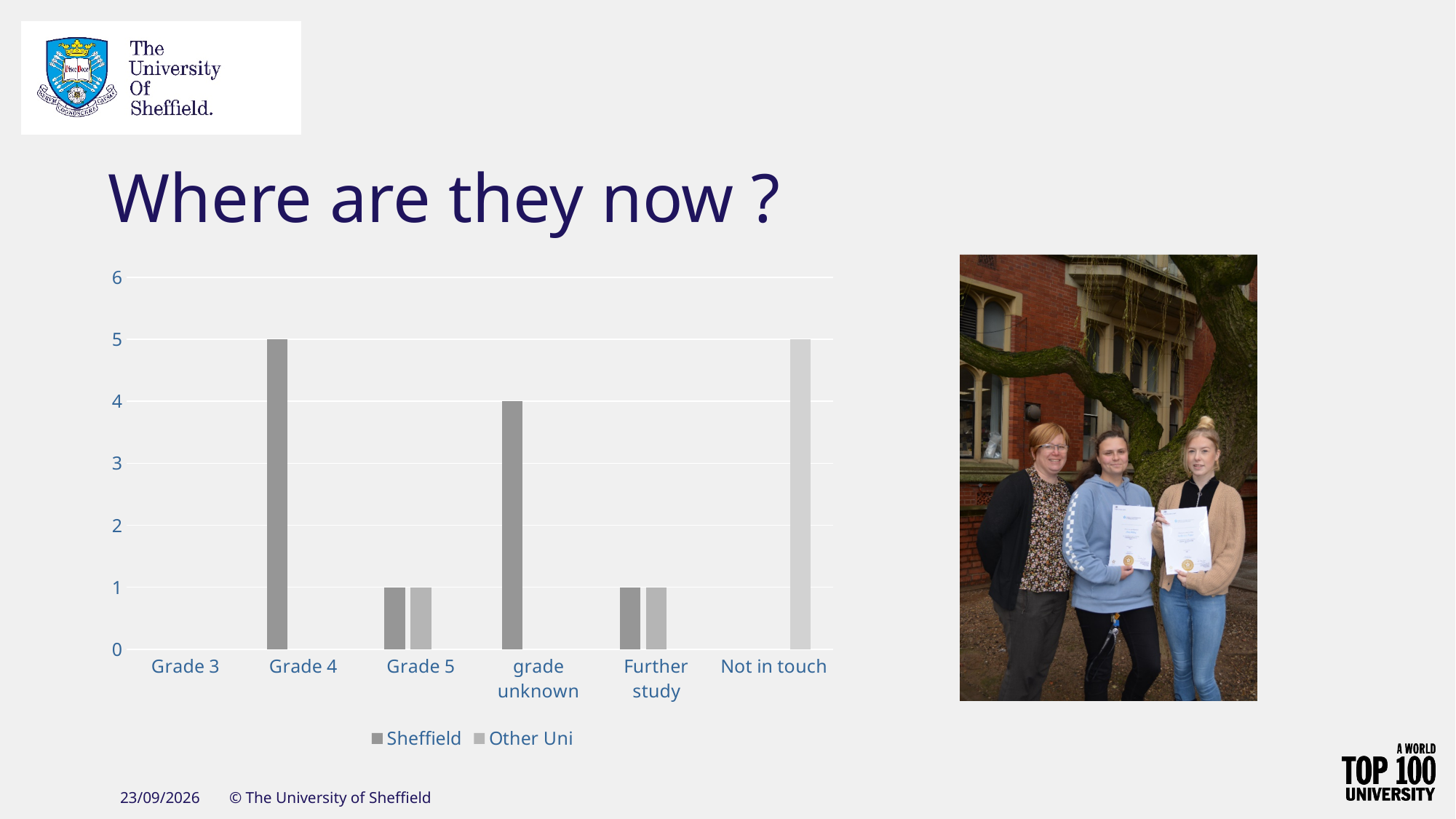
What is the Other Uni value for Grade 5? 1 What are the two series named in the chart legend? Sheffield and Other Uni How many series does the chart legend list? 2 Which category has the highest Sheffield value? Grade 4 What is the Sheffield value for Grade 4? 5 What is the Sheffield value for grade unknown? 4 How many categories are shown on the x axis of the chart? 6 What kind of chart is shown on the slide? bar chart What is the difference between the Sheffield values for Grade 4 and grade unknown? 1 Which is larger, the Sheffield value for Grade 4 or the Sheffield value for Further study? Grade 4